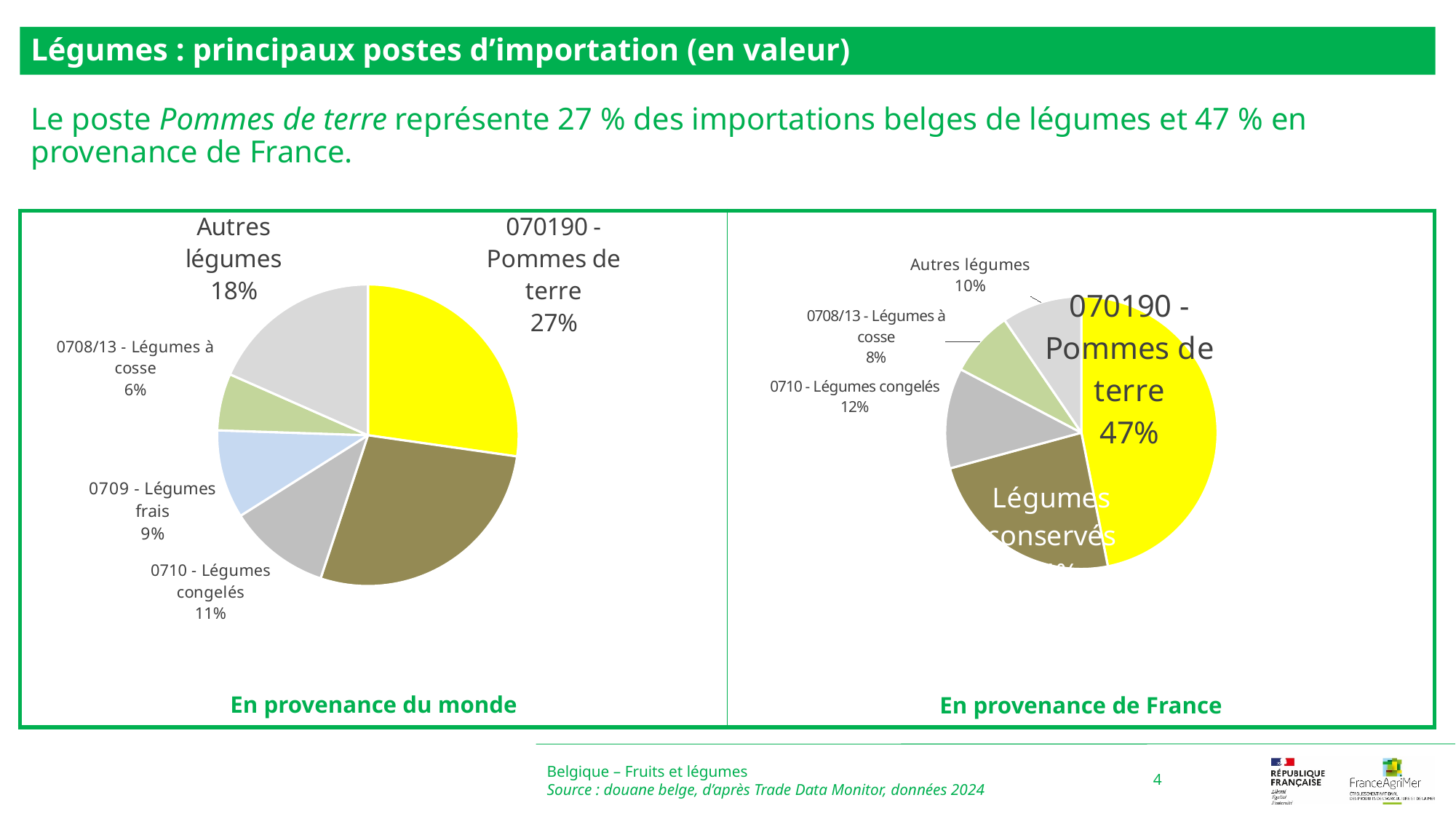
In the 'En provenance du monde' chart, what is the share of 0709 - Légumes frais? 9% What is the difference between the share of Pommes de terre in the 'En provenance de France' chart and in the 'En provenance du monde' chart? 20 percentage points In the 'En provenance du monde' chart, what is the share of 0710 - Légumes congelés? 11% How many slices does the 'En provenance de France' pie chart have? 5 What type of chart is used on the slide for 'En provenance du monde'? Pie chart In the 'En provenance de France' chart, what share do 070190 - Pommes de terre represent? 47% In the 'En provenance du monde' chart, what share do 070190 - Pommes de terre represent? 27% In the 'En provenance du monde' chart, which labelled category has the smallest share? 0708/13 - Légumes à cosse In the 'En provenance de France' chart, what is the share of 0710 - Légumes congelés? 12% In the 'En provenance du monde' chart, which is larger: the share of Autres légumes or the share of 0709 - Légumes frais? Autres légumes In the 'En provenance de France' chart, which category has the largest share? 070190 - Pommes de terre In the 'En provenance de France' chart, what is the share of 0708/13 - Légumes à cosse? 8%